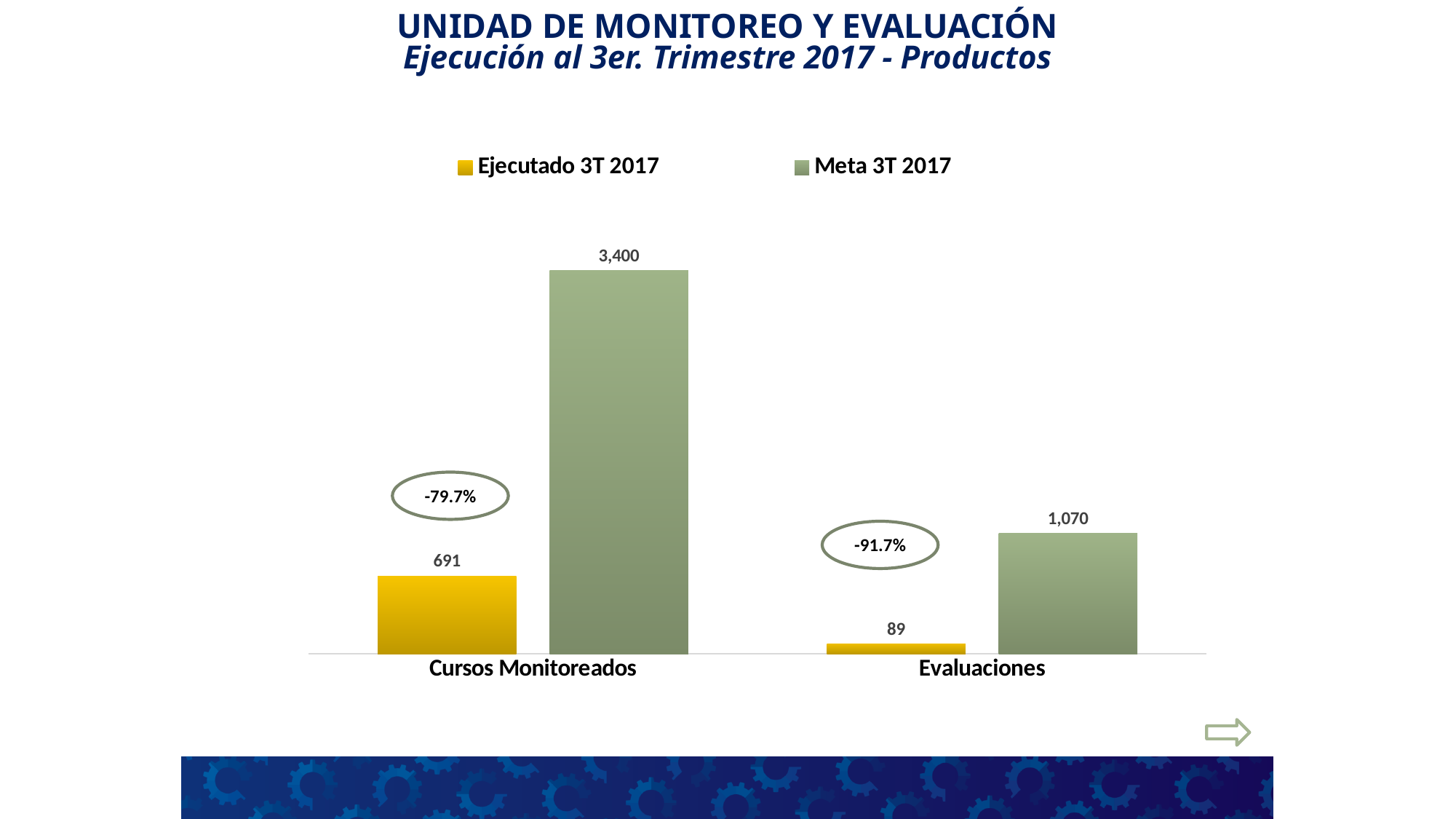
What is the difference between the Meta 3T 2017 and Ejecutado 3T 2017 values for Cursos Monitoreados? 2,709 How many series does the legend list? 2 Which category has the lowest Ejecutado 3T 2017 value? Evaluaciones What is the difference between the Meta 3T 2017 and Ejecutado 3T 2017 values for Evaluaciones? 981 Which category has the highest Meta 3T 2017 value? Cursos Monitoreados What kind of chart is shown on the slide? Bar chart What is the Meta 3T 2017 value for Cursos Monitoreados? 3,400 What is the Ejecutado 3T 2017 value for Cursos Monitoreados? 691 Which is larger: the Ejecutado 3T 2017 value for Cursos Monitoreados or the Meta 3T 2017 value for Evaluaciones? Meta 3T 2017 value for Evaluaciones How many categories are shown on the x axis? 2 What is the Ejecutado 3T 2017 value for Evaluaciones? 89 What is the Meta 3T 2017 value for Evaluaciones? 1,070